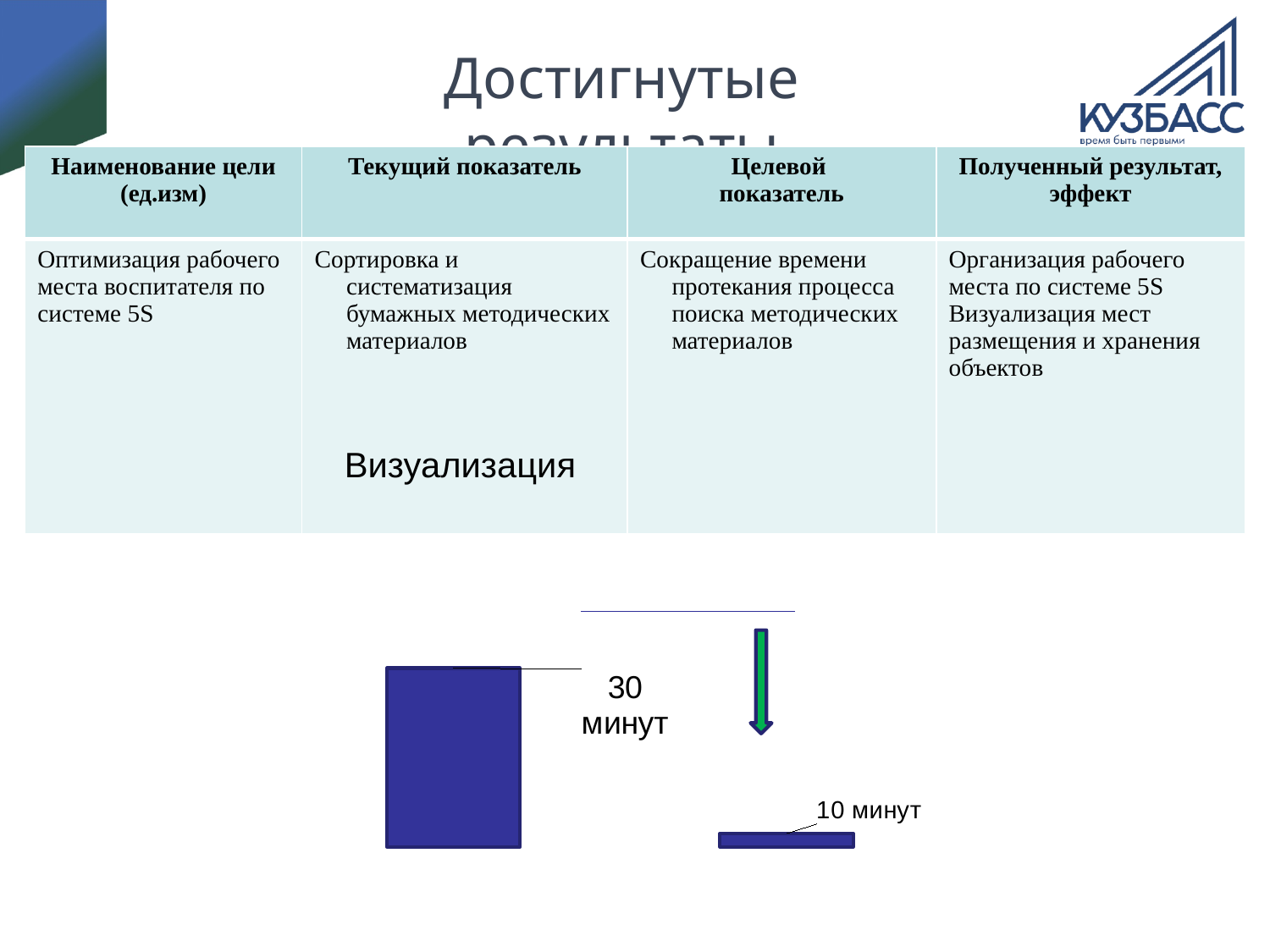
Do the values in the chart rise or fall from left to right? fall In which direction does the green arrow between the two bars point? down What kind of chart is shown at the bottom of the slide? bar chart What is the difference between the left bar (30 минут) and the right bar (10 минут)? 20 минут Is the value of the left bar larger or smaller than the value of the right bar? larger What value is labelled on the right (shorter) bar of the chart? 10 минут How many bars does the chart at the bottom of the slide contain? 2 Which bar in the chart has the highest value, the left or the right one? left What value is labelled on the left (taller) bar of the chart? 30 минут Which bar in the chart has the lowest value, the left or the right one? right What colour are the bars in the chart? blue